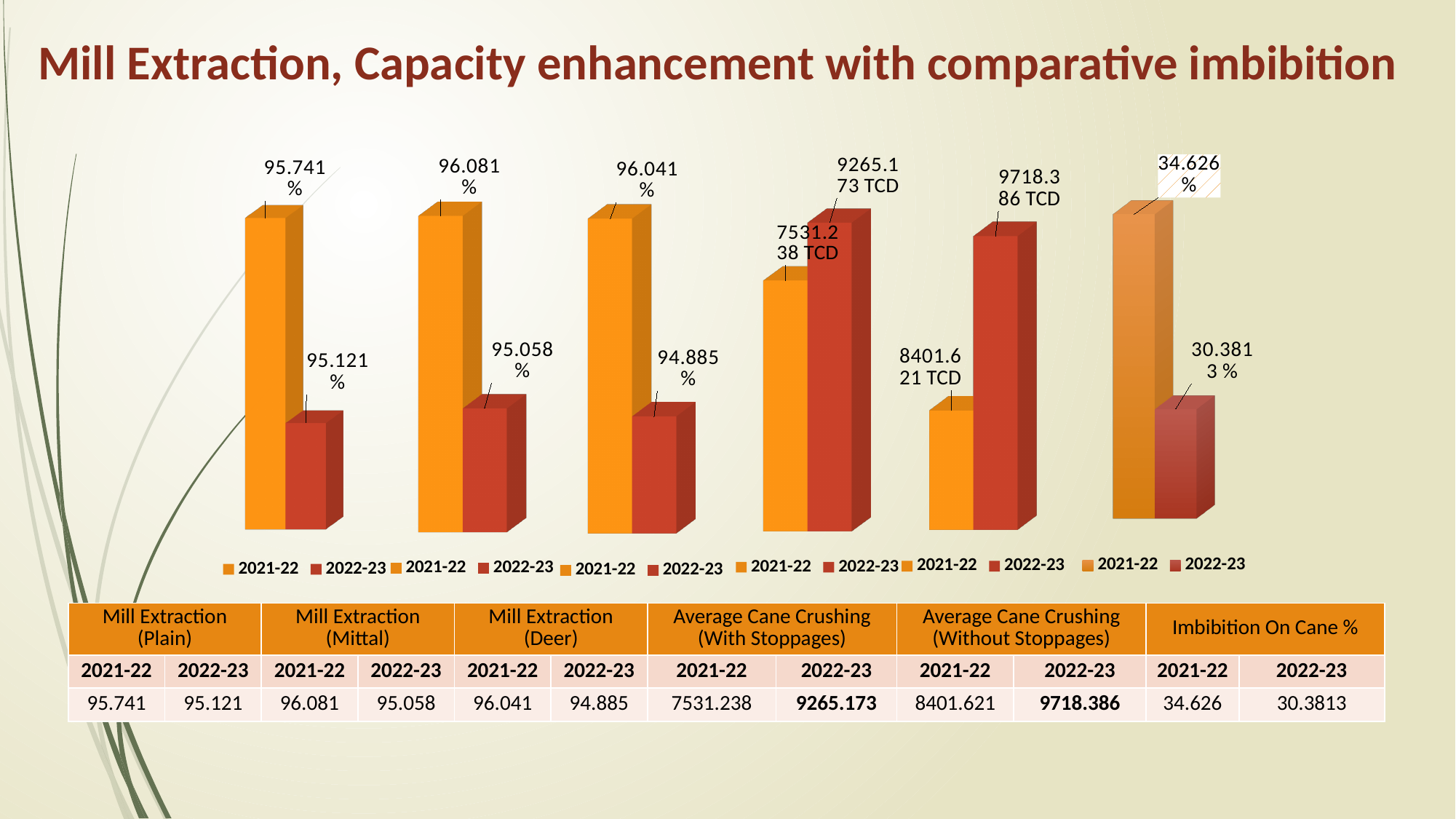
In the fourth chart from the left (Average Cane Crushing (With Stoppages)), which year has the larger value, 2021-22 or 2022-23? 2022-23 In the fifth chart from the left (Average Cane Crushing (Without Stoppages)), what is the difference between the 2022-23 and 2021-22 values? 1316.765 TCD What type of chart is used for the Mill Extraction (Plain) data? Bar chart In the third chart from the left (Mill Extraction (Deer)), which year has the larger value, 2021-22 or 2022-23? 2021-22 How many series does the legend of the first chart from the left list? 2 In the first chart from the left (Mill Extraction (Plain)), what is the value for 2021-22? 95.741 % In the sixth chart from the left (Imbibition On Cane %), what is the value for 2022-23? 30.3813 % In the second chart from the left (Mill Extraction (Mittal)), what is the value for 2022-23? 95.058 % In the first chart from the left (Mill Extraction (Plain)), what is the difference between the 2021-22 and 2022-23 values? 0.620 % How many bars does the sixth chart from the left (Imbibition On Cane %) show? 2 In the fourth chart from the left (Average Cane Crushing (With Stoppages)), what is the value for 2022-23? 9265.173 TCD In the fifth chart from the left (Average Cane Crushing (Without Stoppages)), what is the value for 2021-22? 8401.621 TCD